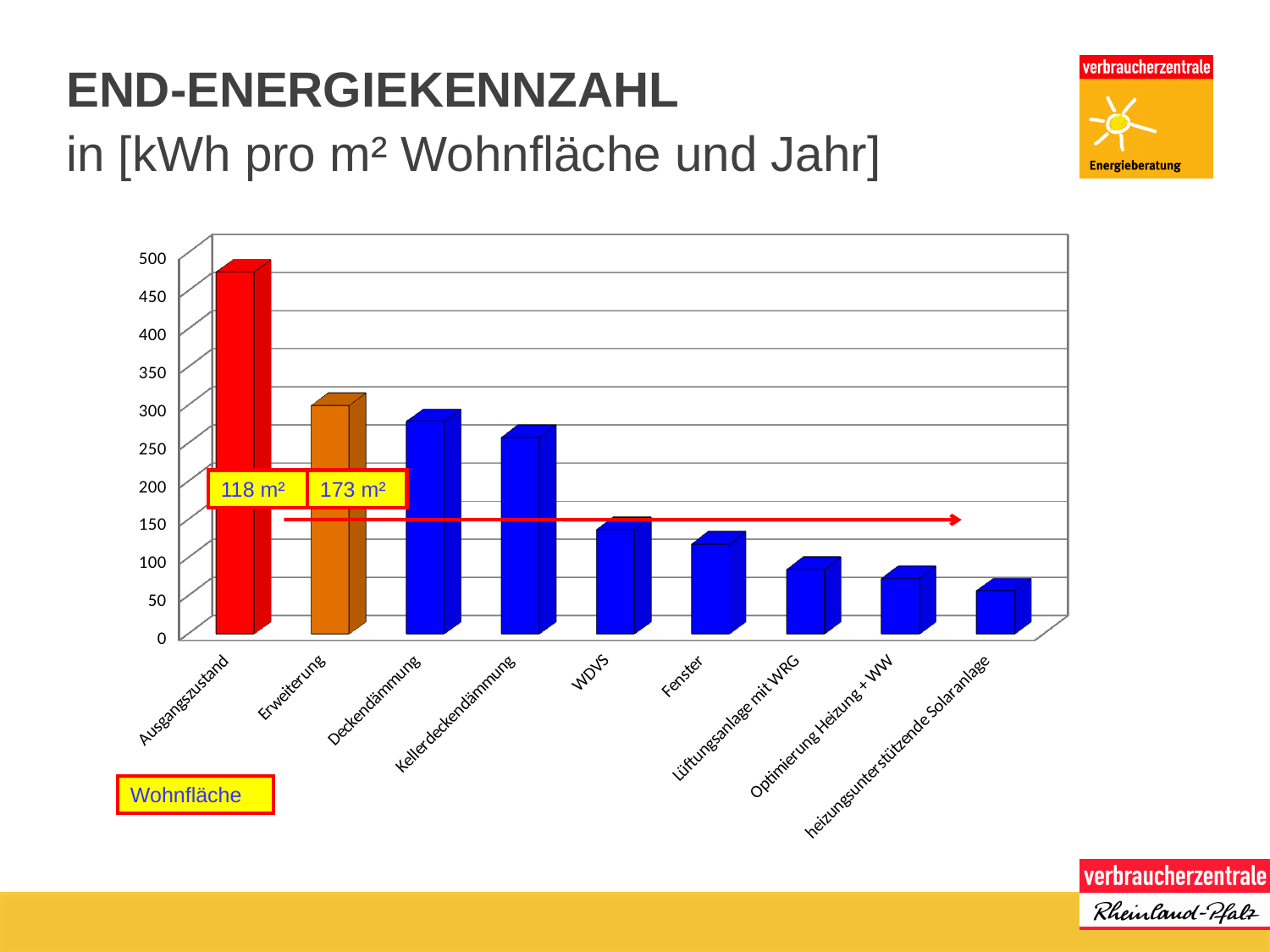
Is the value for Kellerdeckendämmung greater or less than 300? less Do the values rise or fall from left to right along the x axis? fall Which is larger, the value for Ausgangszustand or the value for Erweiterung? Ausgangszustand How many categories are plotted along the x axis? 9 Which category has the highest value? Ausgangszustand What colour is the bar for Ausgangszustand? red Which is larger, the value for WDVS or the value for Fenster? WDVS Is the value for Ausgangszustand greater or less than 400? greater Is the value for Fenster greater or less than 150? less What kind of chart is shown on the slide? bar chart Which category has the lowest value? heizungsunterstützende Solaranlage